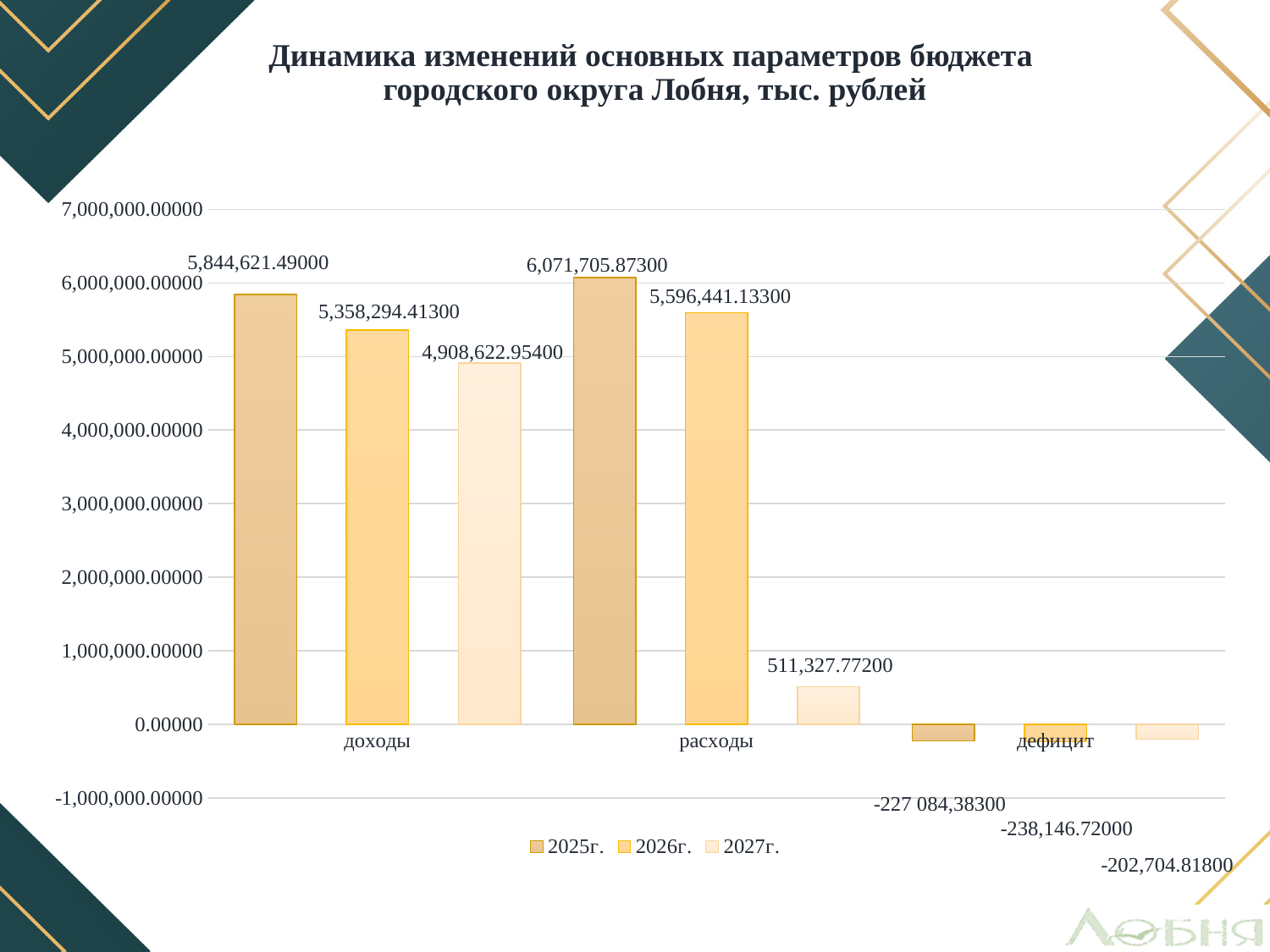
Which year has the lowest value for доходы? 2027г. Which is larger: доходы in 2026г. or расходы in 2027г.? доходы in 2026г. Is the value for расходы in 2025г. greater or less than 6,000,000.00000? greater What is the value for доходы in 2027г.? 4,908,622.95400 What is the value for дефицит in 2026г.? -238,146.72000 What is the value for расходы in 2026г.? 5,596,441.13300 What is the value for доходы in 2025г.? 5,844,621.49000 What is the difference between расходы and доходы in 2025г.? 227,084.38300 How many series does the legend list? 3 Which category has the highest value in the 2025г. series? расходы What kind of chart is shown on the slide? bar chart How many categories are shown on the x axis? 3